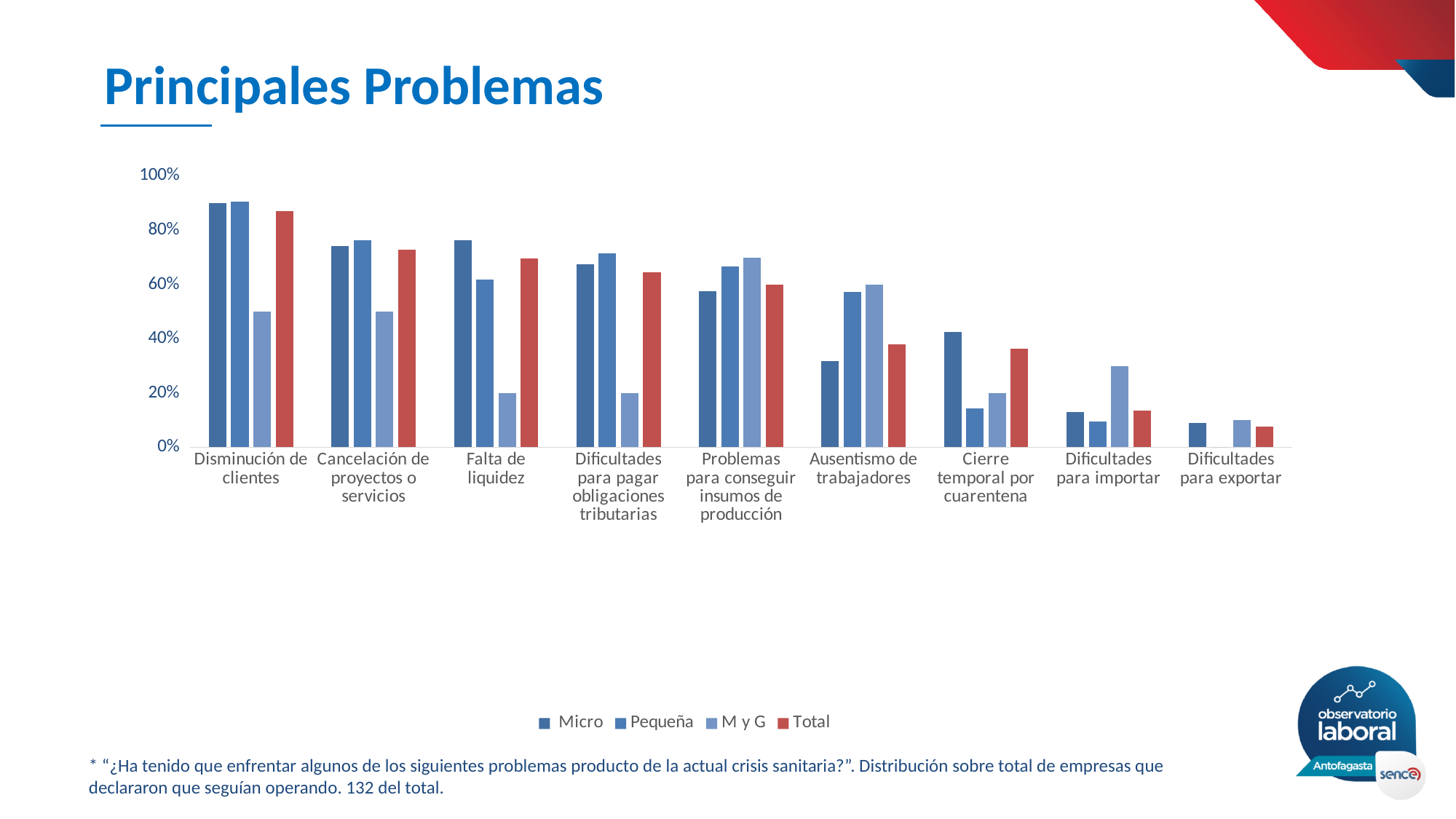
How many series does the legend list? 4 Do the Total values generally rise or fall moving from left to right along the x axis? fall How many problem categories are shown on the x axis? 9 Is the Total value for Disminución de clientes greater or less than 80%? greater What colour represents the Total series in the legend? Red What kind of chart is shown on the slide? Bar chart Which category has the highest M y G value? Problemas para conseguir insumos de producción For Cierre temporal por cuarentena, which is larger: the Micro value or the Pequeña value? Micro Which category has the highest Total value? Disminución de clientes Is the M y G value for Falta de liquidez greater or less than 40%? less For Dificultades para importar, which is larger: the Micro value or the M y G value? M y G Which category has the lowest Total value? Dificultades para exportar